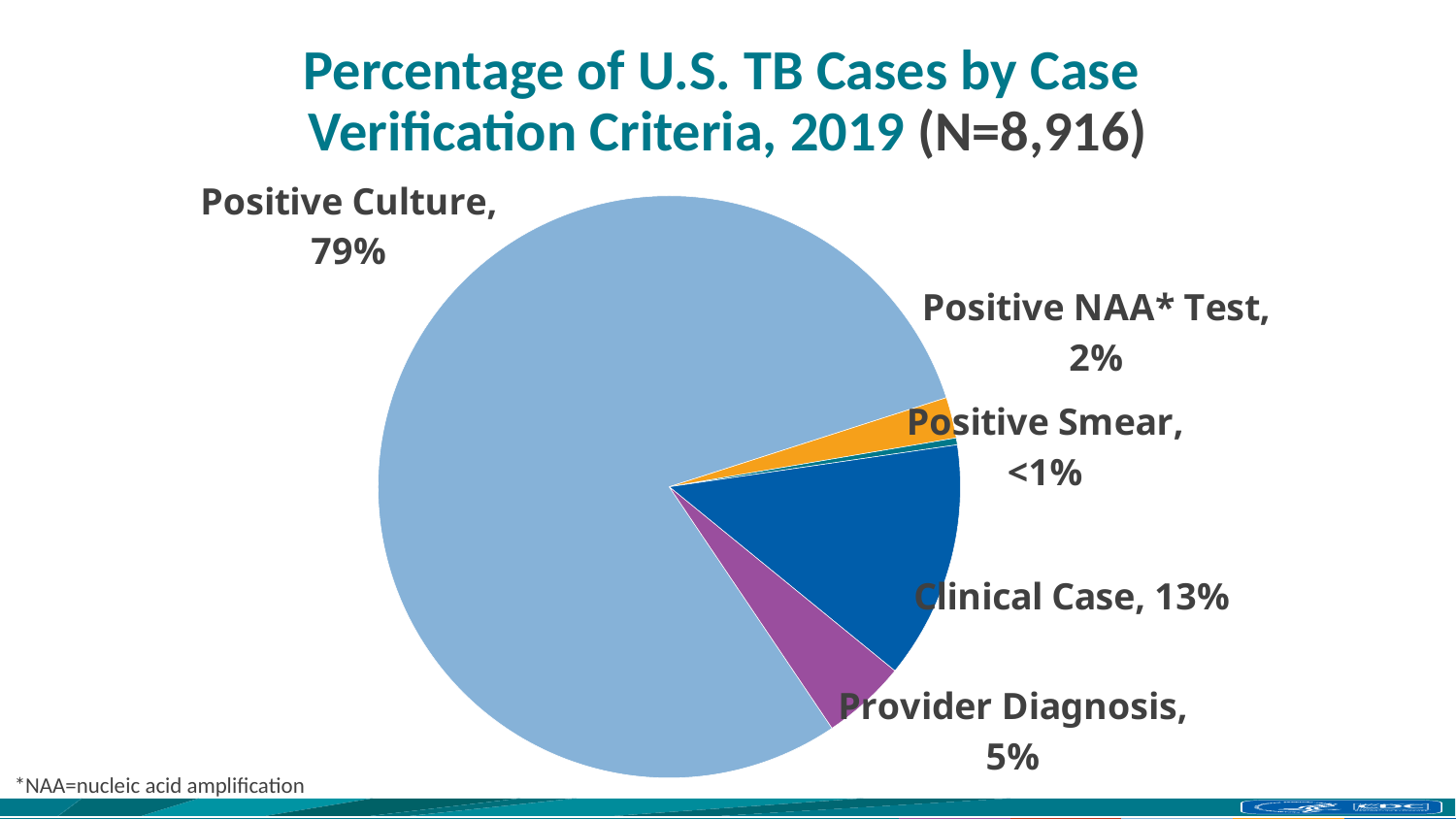
What percentage of cases were verified as Clinical Case? 13% How many slices does the pie chart have? 5 What is the total number of cases (N) stated in the chart title? 8,916 Which case verification criterion accounts for the smallest share of cases? Positive Smear What percentage of cases were verified by Provider Diagnosis? 5% What percentage of cases were verified by Positive Smear? <1% What is the difference in percentage points between Positive Culture and Clinical Case? 66 Which case verification criterion accounts for the largest share of cases? Positive Culture What kind of chart is shown on the slide? pie chart What percentage of cases were verified by Positive NAA* Test? 2% What percentage of U.S. TB cases were verified by Positive Culture? 79% Which is larger, the share for Clinical Case or the share for Provider Diagnosis? Clinical Case